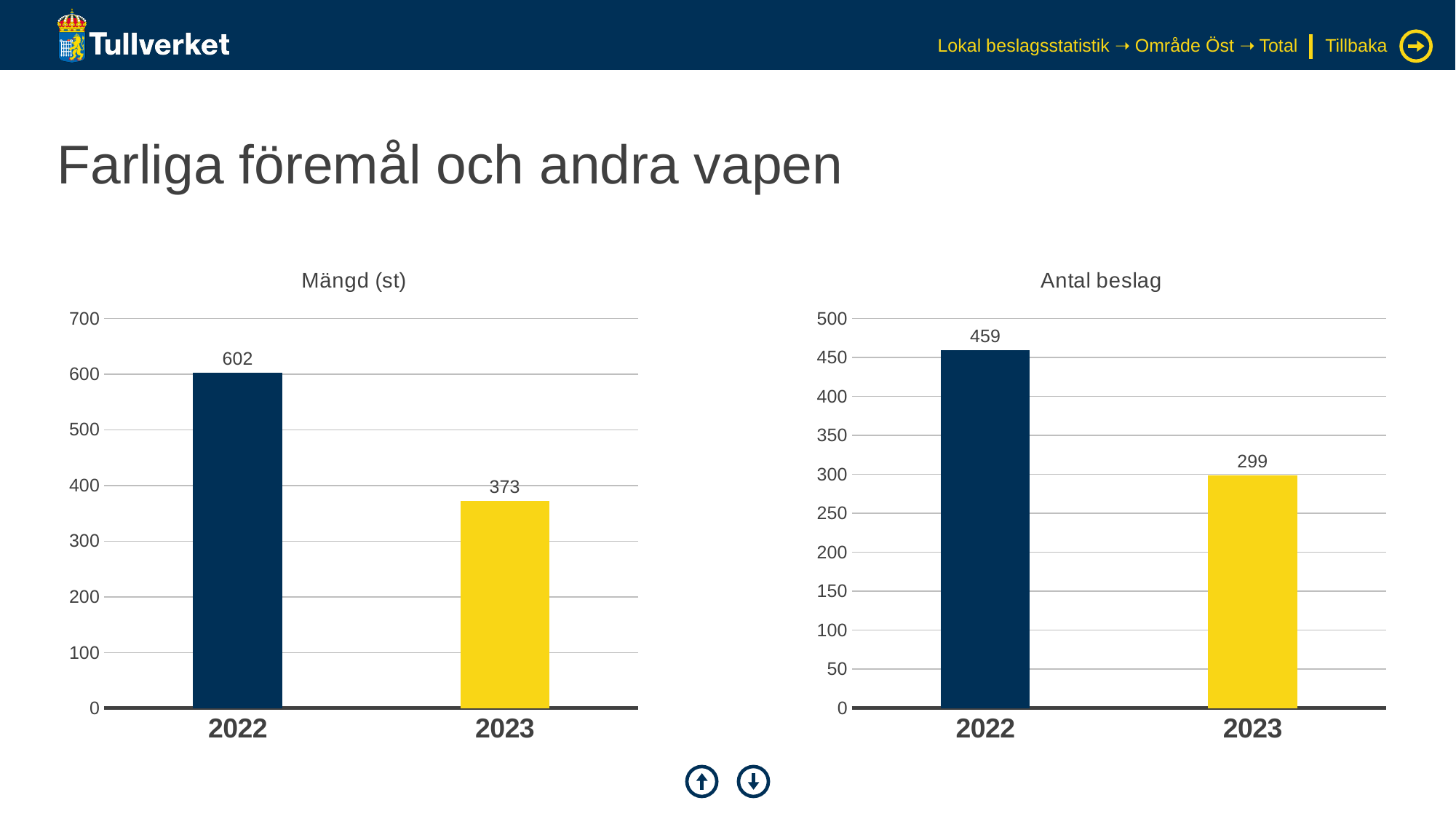
In the 'Antal beslag' chart, is the value for 2022 greater or less than 400? greater In the 'Mängd (st)' chart, which year has the highest value? 2022 In the 'Mängd (st)' chart, do the values rise or fall from 2022 to 2023? fall How many categories are shown on the x axis of the 'Antal beslag' chart? 2 In the 'Antal beslag' chart, what is the value for 2022? 459 In the 'Antal beslag' chart, which year has the lowest value? 2023 In the 'Mängd (st)' chart, what is the value for 2023? 373 In the 'Mängd (st)' chart, what is the difference between the 2022 and 2023 values? 229 In the 'Antal beslag' chart, what is the difference between the 2022 and 2023 values? 160 What kind of chart is the 'Mängd (st)' chart? bar chart In the 'Antal beslag' chart, what is the value for 2023? 299 In the 'Mängd (st)' chart, what is the value for 2022? 602